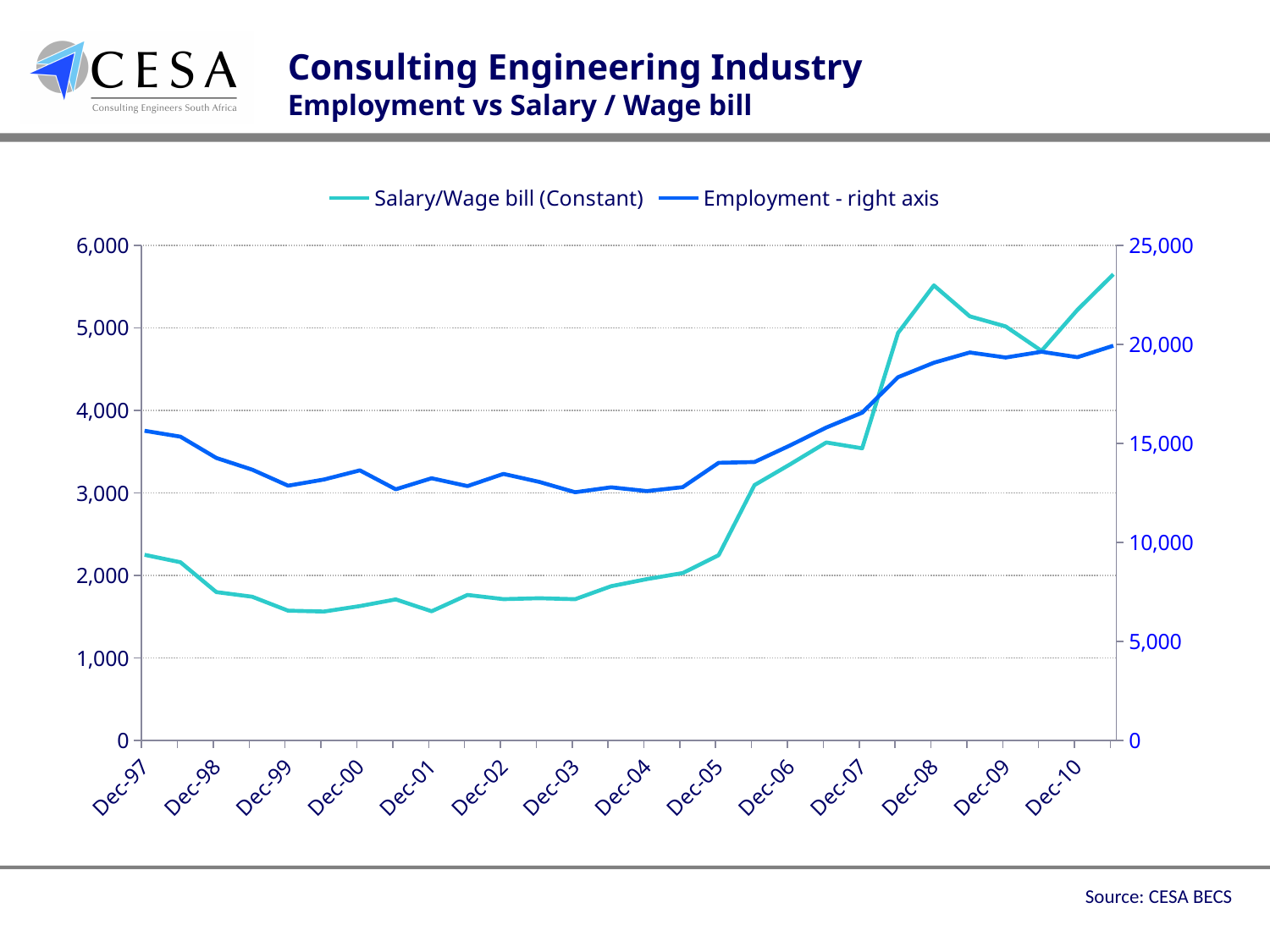
Does the Employment series rise or fall between Dec-97 and Dec-99? fall What kind of chart is shown on the slide? Line chart Is the Employment value at Dec-10 greater or less than 15,000? greater Is the Employment value at Dec-04 greater or less than 15,000? less How many dated labels are shown along the x axis? 14 Is the Salary/Wage bill (Constant) value at Dec-01 greater or less than 2,000? less Which series is plotted against the right axis? Employment What is the title of the chart on the slide? Consulting Engineering Industry Employment vs Salary / Wage bill How many series does the legend list? 2 Does the Salary/Wage bill (Constant) series rise or fall between Dec-05 and Dec-08? rise